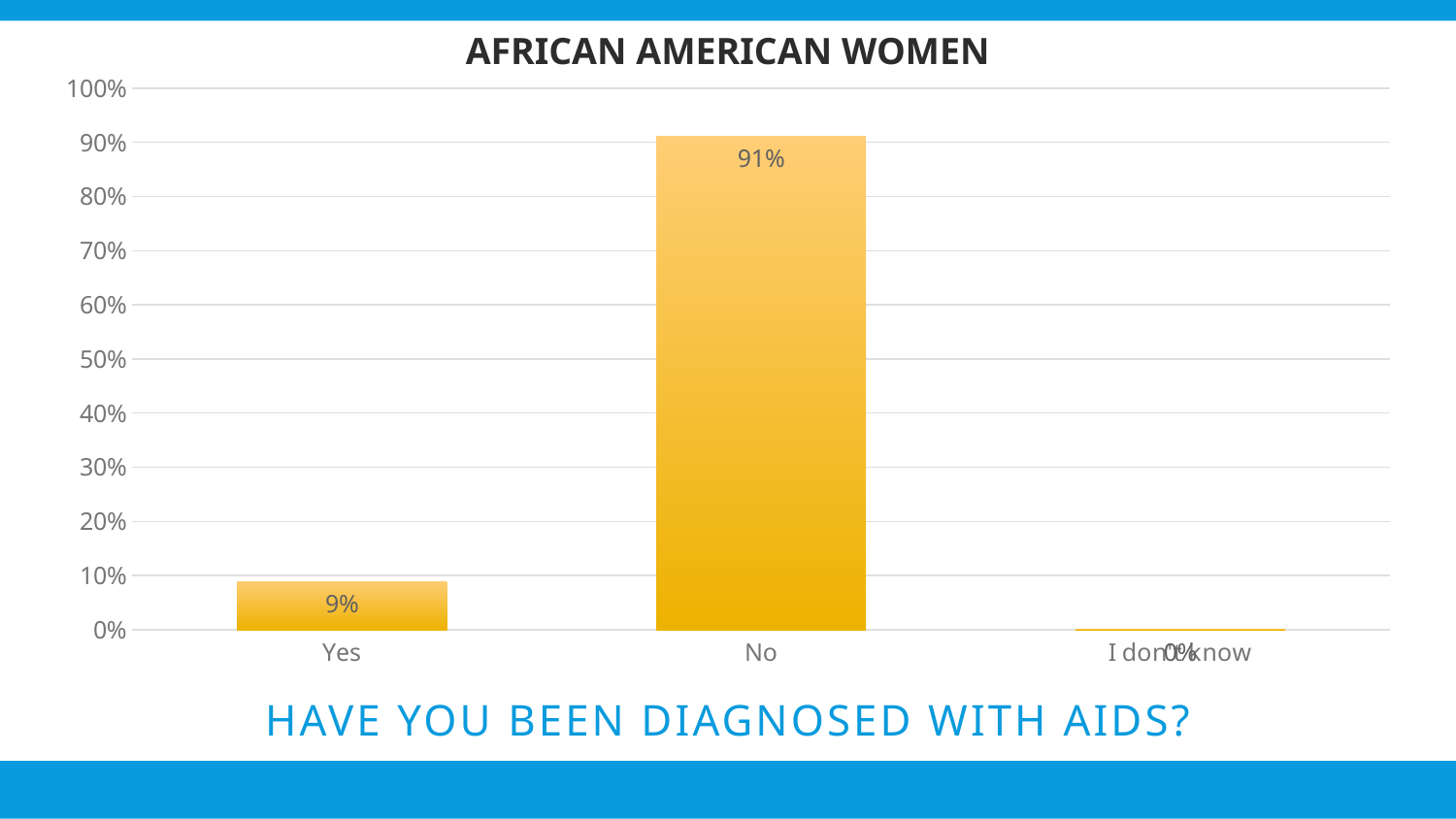
Which category has the lowest value? I don't know What is the difference between the values for "No" and "Yes"? 82% Which is larger, the value for "Yes" or the value for "No"? No Is the value for "Yes" greater or less than 20%? less What is the title of the chart? AFRICAN AMERICAN WOMEN What is the value for "Yes"? 9% Which category has the highest value? No How many categories are shown on the x axis? 3 What kind of chart is shown on the slide? Bar chart What is the value for "No"? 91% What is the value for "I don't know"? 0% Is the value for "No" greater or less than 80%? greater